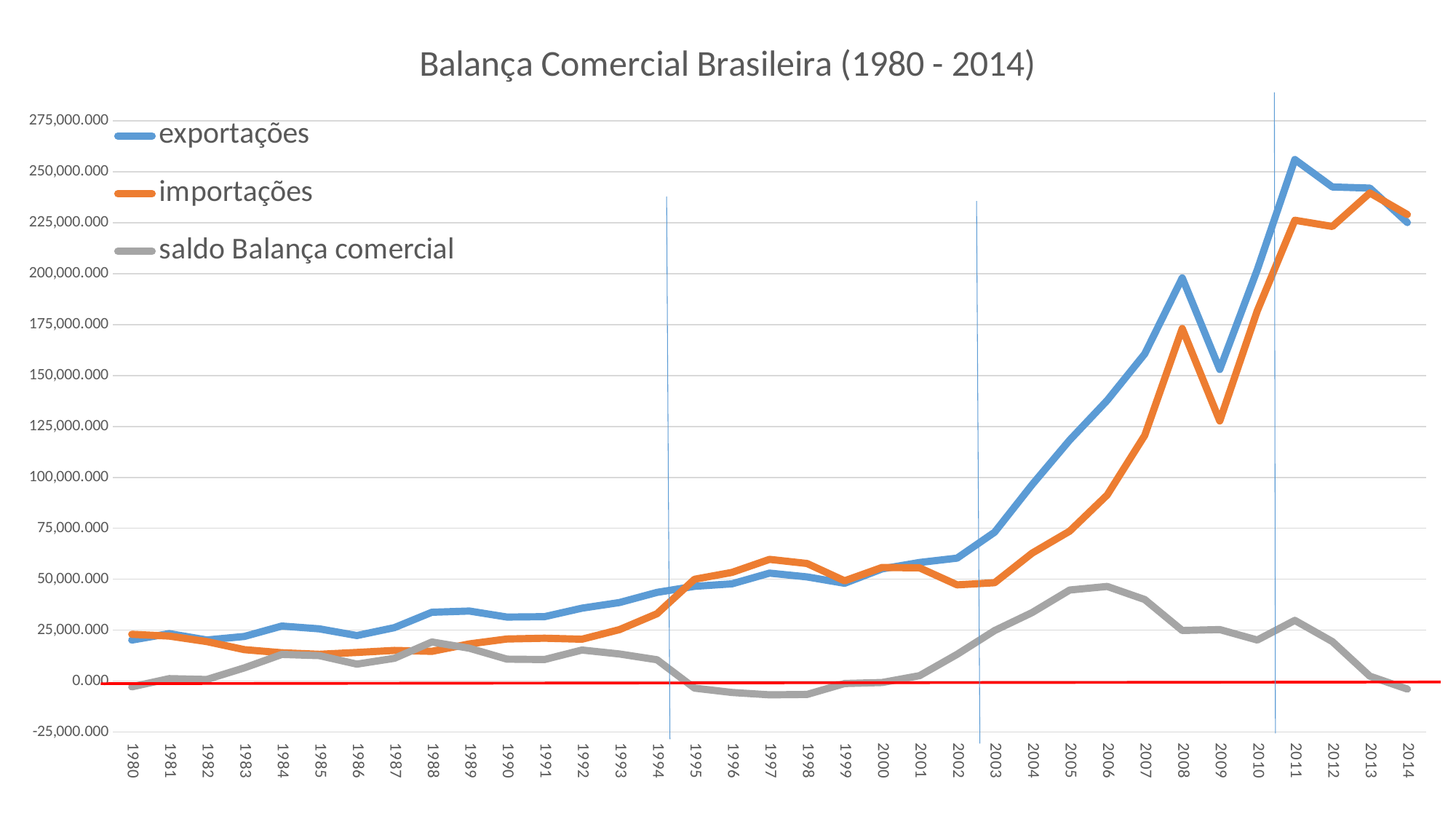
Is the value of importações in 2009 greater or less than 150,000.000? less How many series does the legend list? 3 In which year does the importações line reach its highest value? 2013 Do the exportações values rise or fall from 2002 to 2008? rise Is the value of exportações in 2008 greater or less than 175,000.000? greater Which colour is used for the importações line? orange Is the value of saldo Balança comercial in 2006 greater or less than 25,000.000? greater In 1997, which is larger: exportações or importações? importações How many years are plotted along the x axis? 35 What is the title of the chart? Balança Comercial Brasileira (1980 - 2014) In which year does the exportações line reach its highest value? 2011 What kind of chart is shown on the slide? line chart